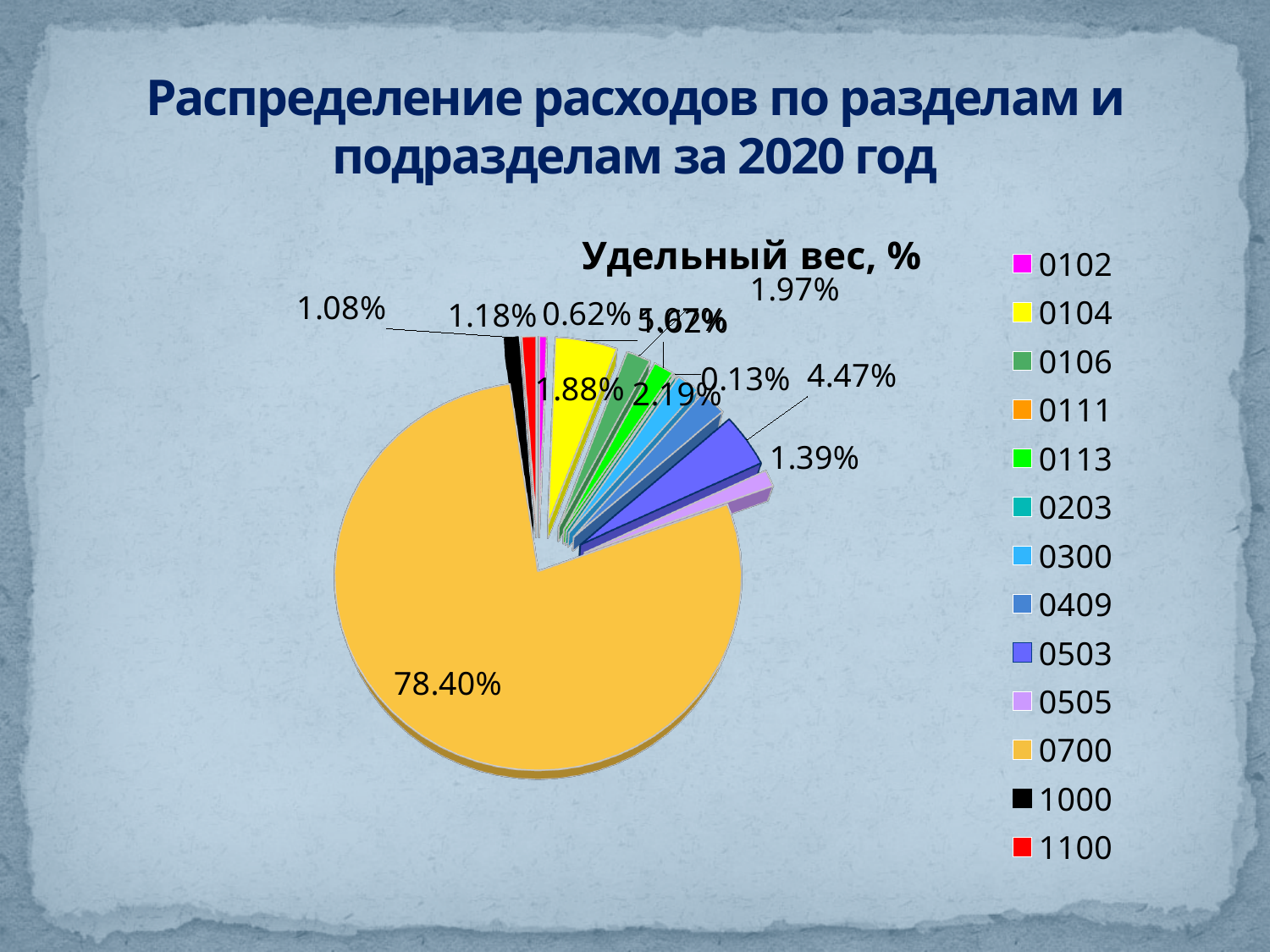
What is the value shown for category 0505? 1.39% What is the value shown for category 0503? 4.47% What colour is the slice for category 0700? orange How many categories does the legend of the pie chart list? 13 What kind of chart is shown on the slide? pie chart What is the title of the chart? Удельный вес, % What is the difference between the values for 0503 and 0505? 3.08% Which is larger, the slice for 0503 or the slice for 0505? 0503 What share of the pie does category 0700 have? 78.40% What is the value shown for category 1000? 1.08% What is the value shown for category 0104? 5.07% Which category has the largest slice of the pie? 0700